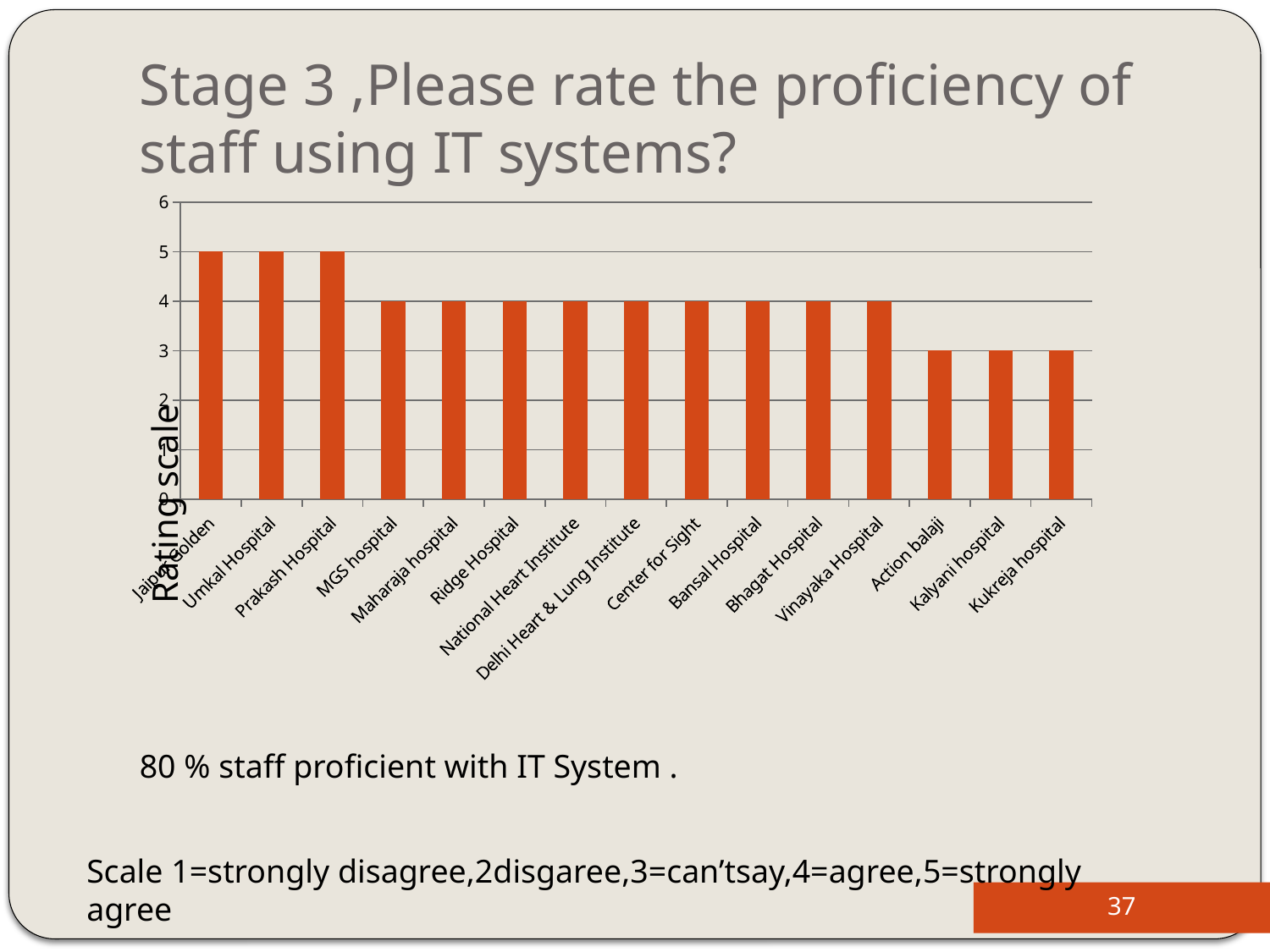
How many hospitals are shown on the x axis of the chart? 15 What rating does Umkal Hospital have on the chart? 5 What rating does Ridge Hospital have on the chart? 4 Is the value for Center for Sight greater or less than 3? greater Which has a higher rating, Umkal Hospital or Bansal Hospital? Umkal Hospital What rating does Kukreja hospital have on the chart? 3 What is the lowest rating value reached by any bar on the chart? 3 What is the highest rating value reached by any bar on the chart? 5 What is the label on the vertical axis of the chart? Rating scale What kind of chart is shown on the slide? Bar chart What rating does Action balaji have on the chart? 3 What is the difference between the ratings of Prakash Hospital and Kalyani hospital? 2